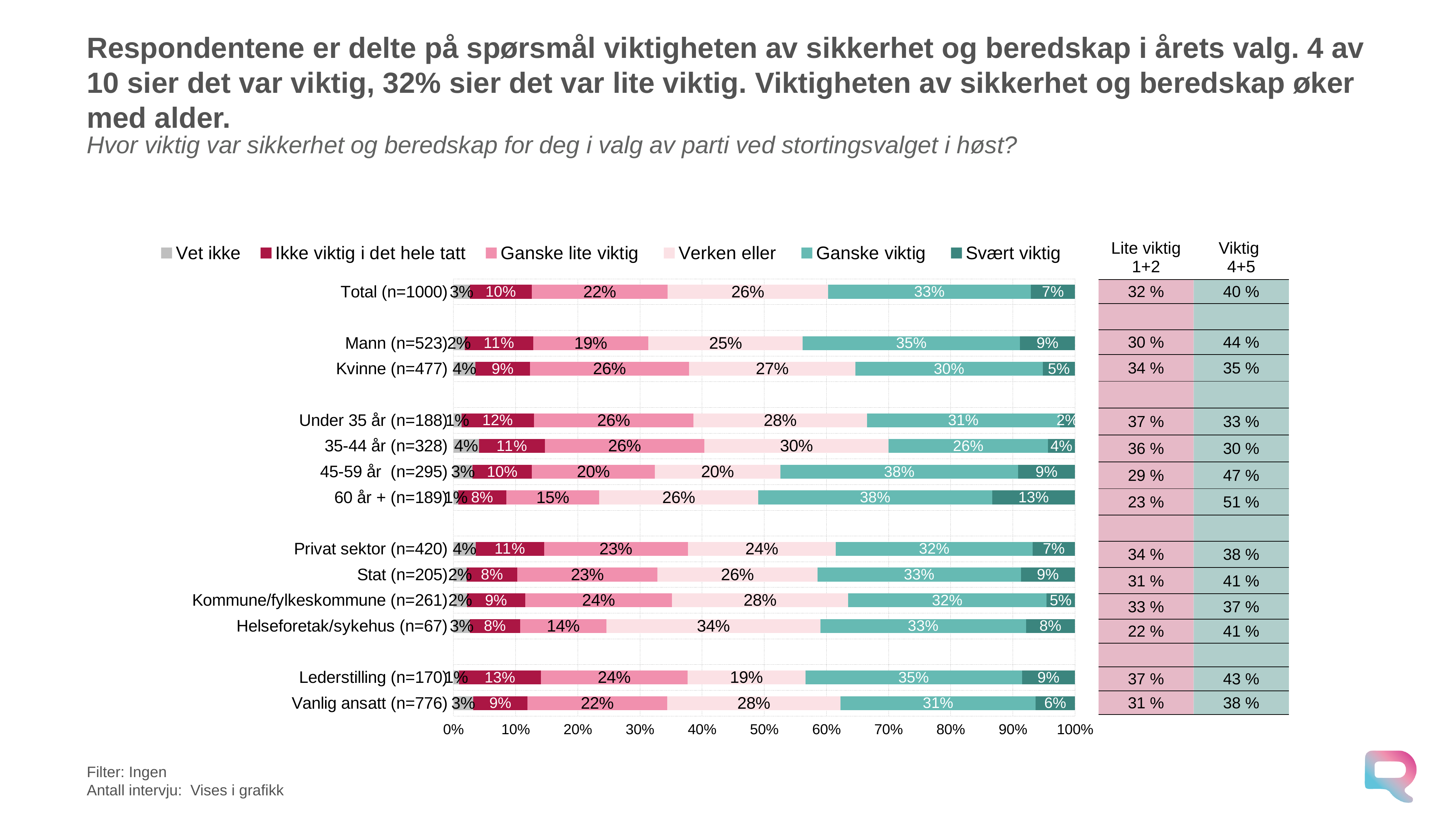
What kind of chart is shown on the slide? stacked bar chart Which category has the highest value for 'Svært viktig'? 60 år + (n=189) In the 'Viktig 4+5' column of the table, what is the value for 60 år + (n=189)? 51 % Which category has the lowest value for 'Ganske lite viktig'? Helseforetak/sykehus (n=67) What is the value for 'Svært viktig' for 60 år + (n=189)? 13% What is the value for 'Ganske viktig' for Total (n=1000)? 33% What is the value for 'Verken eller' for Helseforetak/sykehus (n=67)? 34% Which legend entry is shown in the darkest teal colour? Svært viktig Which has the larger 'Ikke viktig i det hele tatt' value, Lederstilling (n=170) or Vanlig ansatt (n=776)? Lederstilling (n=170) What is the difference between the 'Ganske viktig' values for Mann (n=523) and Kvinne (n=477)? 5 percentage points How many series does the legend list? 6 How many respondent groups (categories) are plotted in the chart? 13